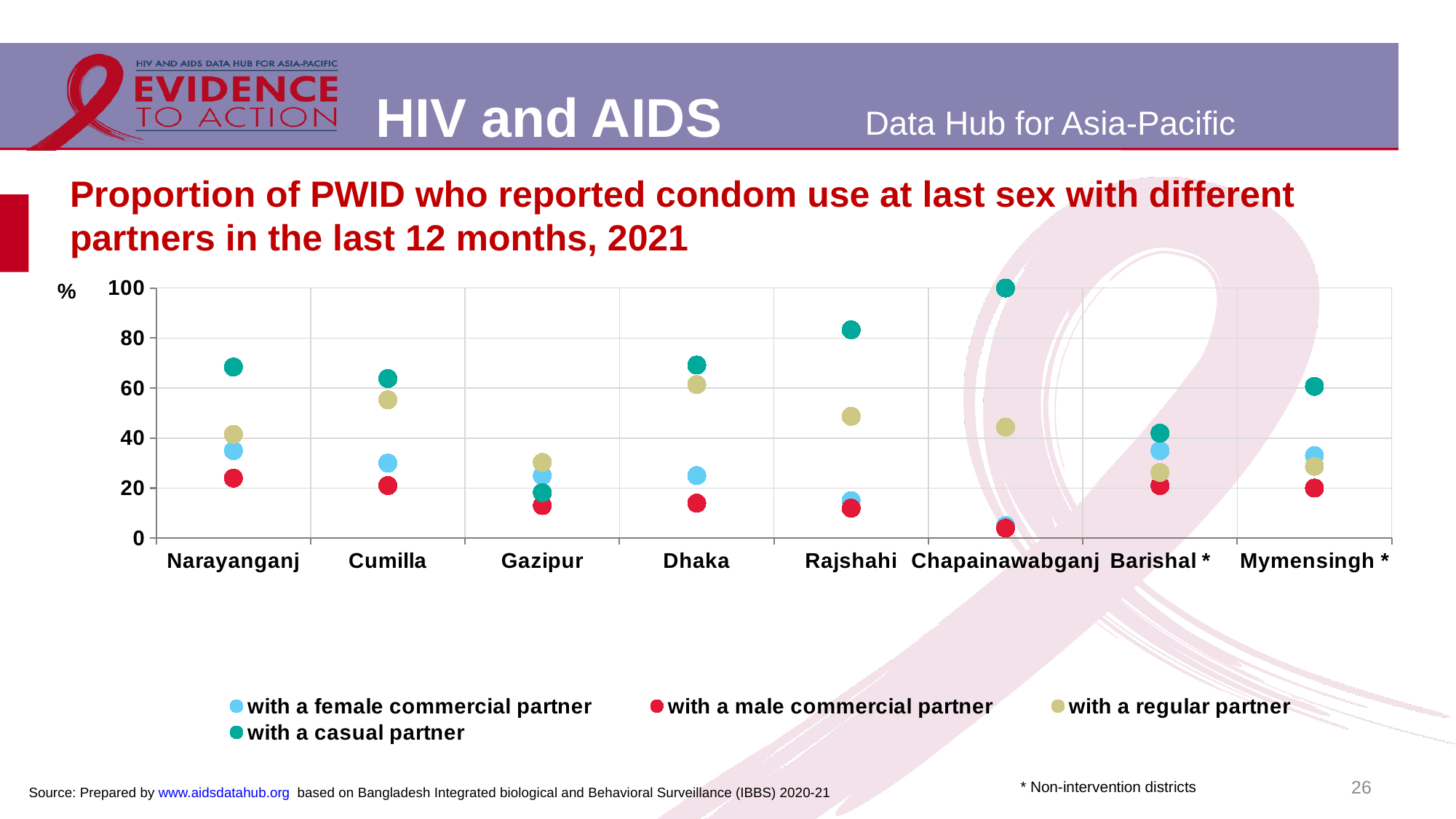
Which district has the highest proportion reporting condom use with a casual partner? Chapainawabganj Is the value for condom use with a casual partner in Narayanganj greater or less than 60? greater What kind of chart is shown on the slide? Dot (scatter) chart Which is larger: condom use with a regular partner in Dhaka or in Gazipur? Dhaka How many districts are shown on the x axis? 8 Which district has the lowest proportion reporting condom use with a casual partner? Gazipur Is the value for condom use with a male commercial partner in Chapainawabganj greater or less than 20? less Is the value for condom use with a casual partner in Rajshahi greater or less than 80? greater What colour represents 'with a casual partner' in the legend? Teal green How many series does the legend list? 4 Which district has the highest proportion reporting condom use with a regular partner? Dhaka